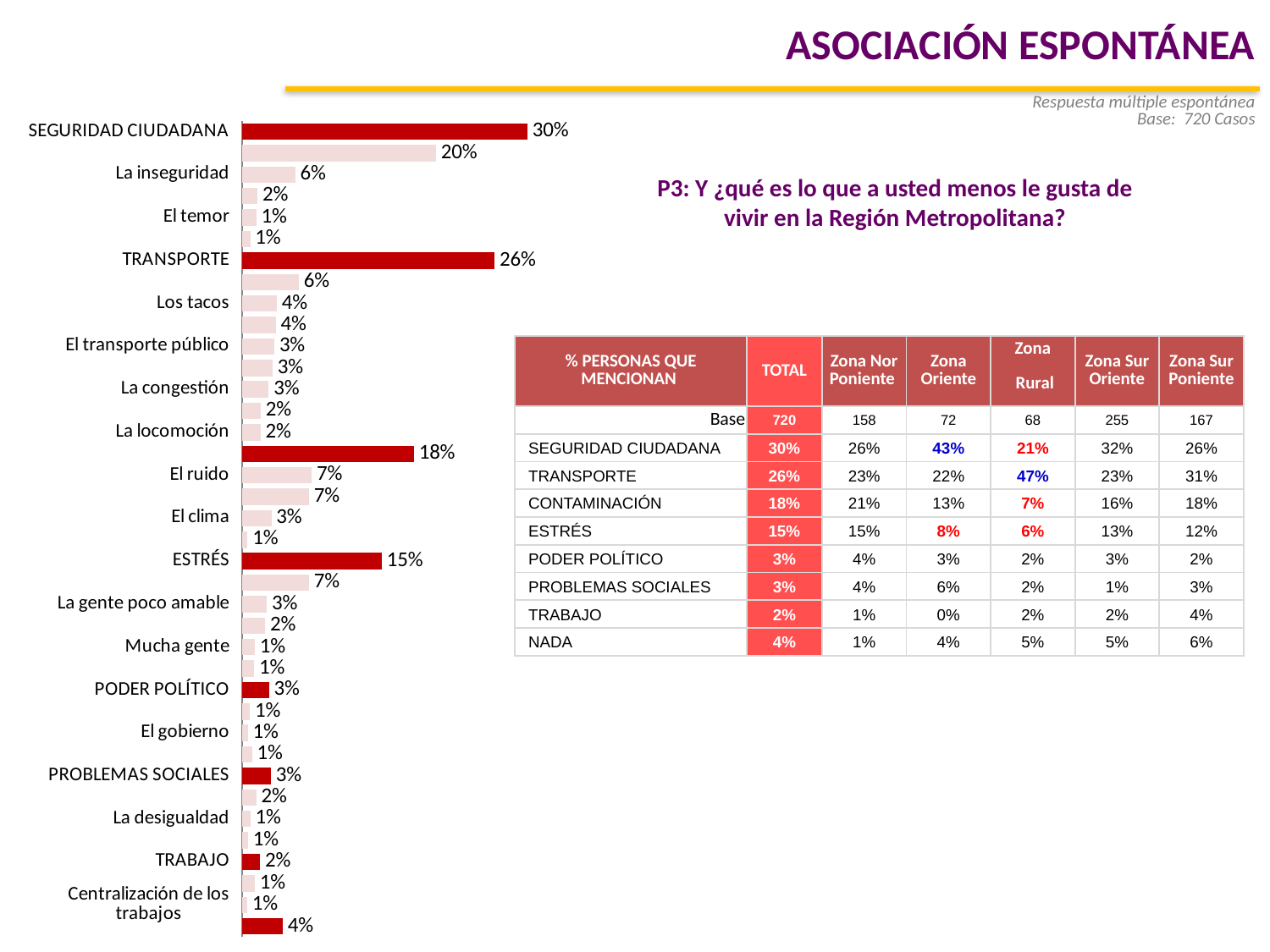
Which has a larger value in the bar chart, ESTRÉS or TRANSPORTE? TRANSPORTE What is the difference between the values for SEGURIDAD CIUDADANA and TRANSPORTE in the bar chart? 4 percentage points What value is shown for TRANSPORTE in the bar chart? 26% What value is shown for PODER POLÍTICO in the bar chart? 3% Which category has the highest value in the bar chart? SEGURIDAD CIUDADANA What value is shown for SEGURIDAD CIUDADANA in the bar chart? 30% What value is shown for Los tacos in the bar chart? 4% What type of chart is shown on the left of the slide? Bar chart What value is shown for La inseguridad in the bar chart? 6% What value is shown for ESTRÉS in the bar chart? 15% What value is shown for El ruido in the bar chart? 7% Which has a larger value in the bar chart, El ruido or El clima? El ruido